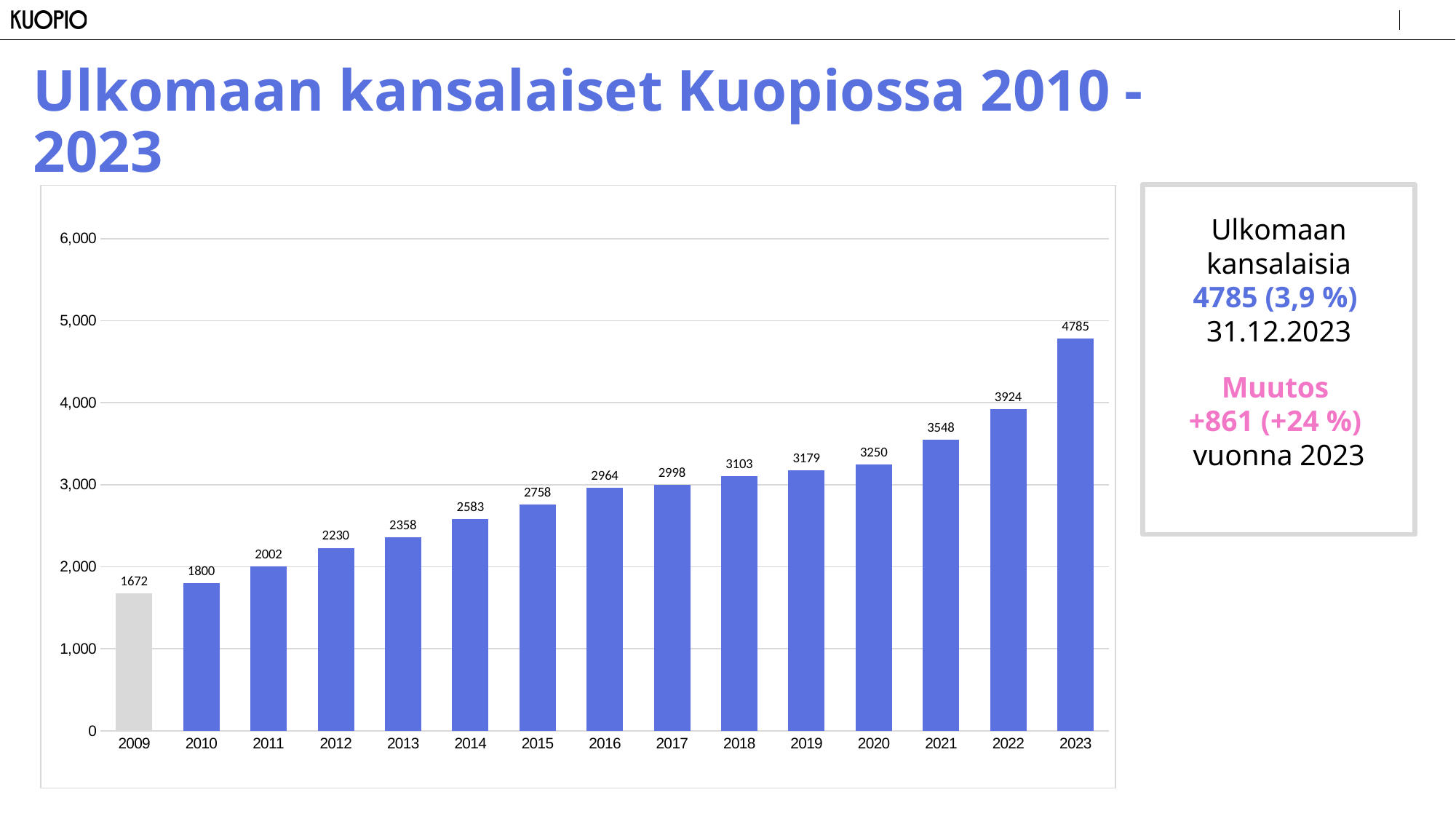
What is the value for 2015? 2758 Is the value for 2021 greater or less than 3,000? greater What is the value for 2020? 3250 Which year has the lowest value? 2009 What is the value for 2009? 1672 What is the difference between the values for 2012 and 2011? 228 How many years are shown on the x axis? 15 Which is larger, the value for 2018 or the value for 2017? 2018 What is the difference between the values for 2023 and 2022? 861 Which year has the highest value? 2023 What kind of chart is shown? bar chart Do the values rise or fall from 2009 to 2023? rise